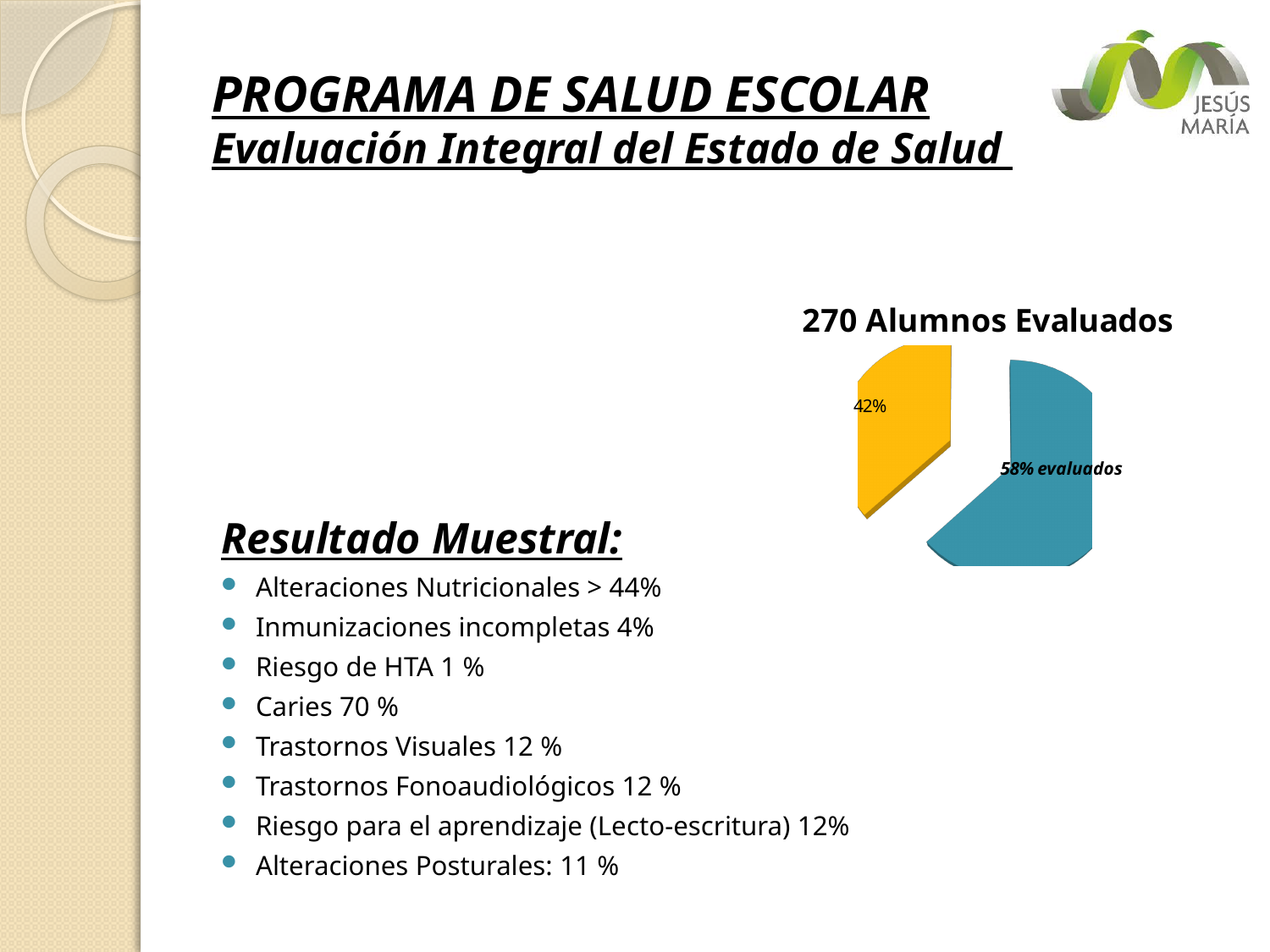
What kind of chart is shown on the slide? pie chart What is the title of the pie chart? 270 Alumnos Evaluados What percentage is shown on the yellow slice of the pie chart? 42% What is the difference in percentage points between the two slices of the pie chart? 16 How many slices does the pie chart have? 2 Which slice is larger in the pie chart, the teal one or the yellow one? the teal one What percentage is shown on the teal slice of the pie chart? 58% What colour is the slice labelled 42% in the pie chart? yellow Which slice of the pie chart is the smallest? 42% Which slice of the pie chart is the largest? 58% evaluados What is the full data label on the larger slice of the pie chart? 58% evaluados Is the value of the yellow slice in the pie chart greater or less than 50%? less